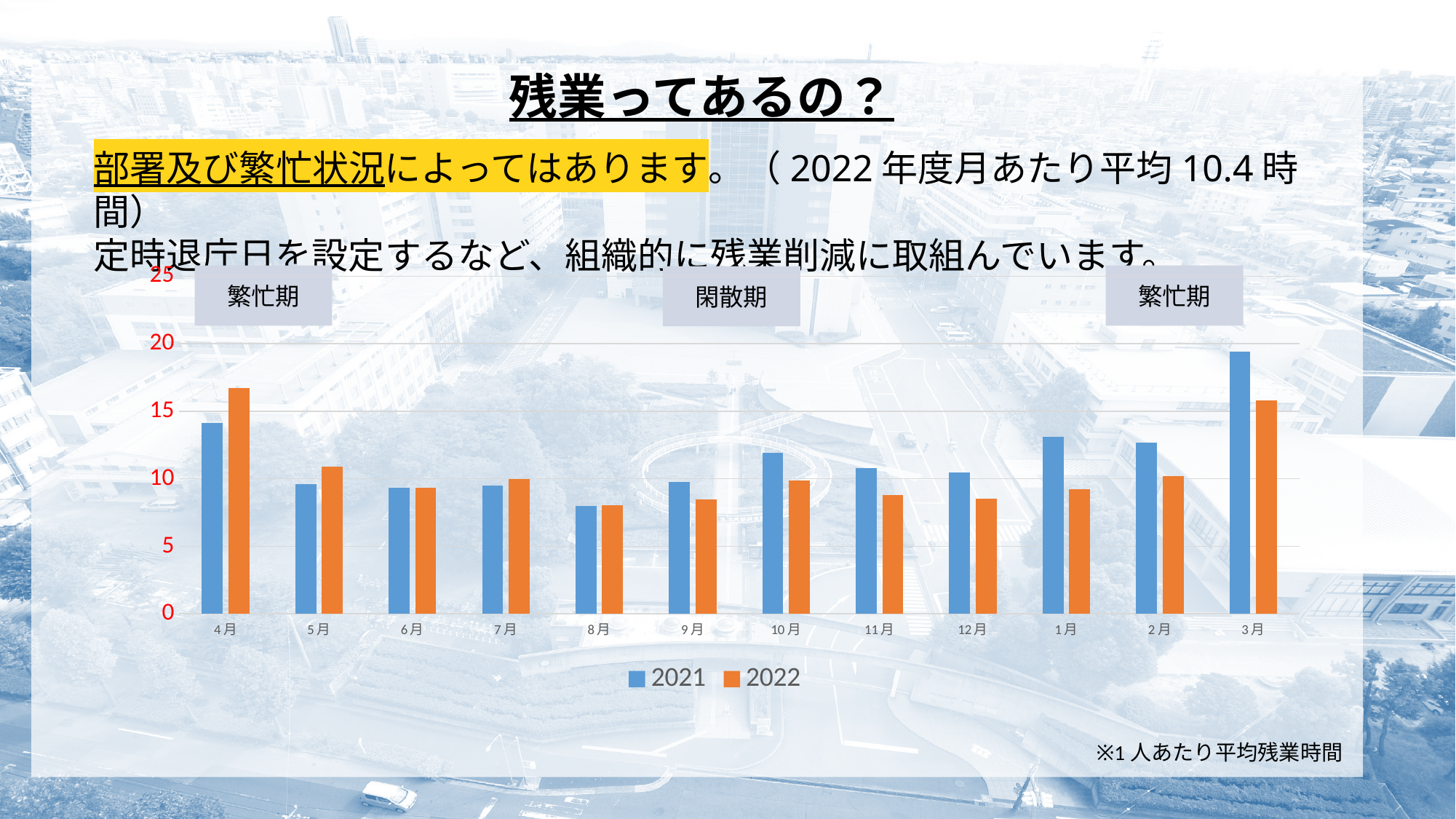
For 4月, which series has the larger value, 2021 or 2022? 2022 How many series does the chart legend list? 2 Is the 2021 value for 3月 greater or less than 15? greater Which month has the highest value for the 2021 series? 3月 Which month has the lowest value for the 2021 series? 8月 Is the 2021 value for 8月 greater or less than 10? less How many months are shown along the x axis of the chart? 12 Is the 2022 value for 4月 greater or less than 15? greater Which series is shown in orange in the chart? 2022 For 3月, which series has the larger value, 2021 or 2022? 2021 What kind of chart is shown on the slide? bar chart